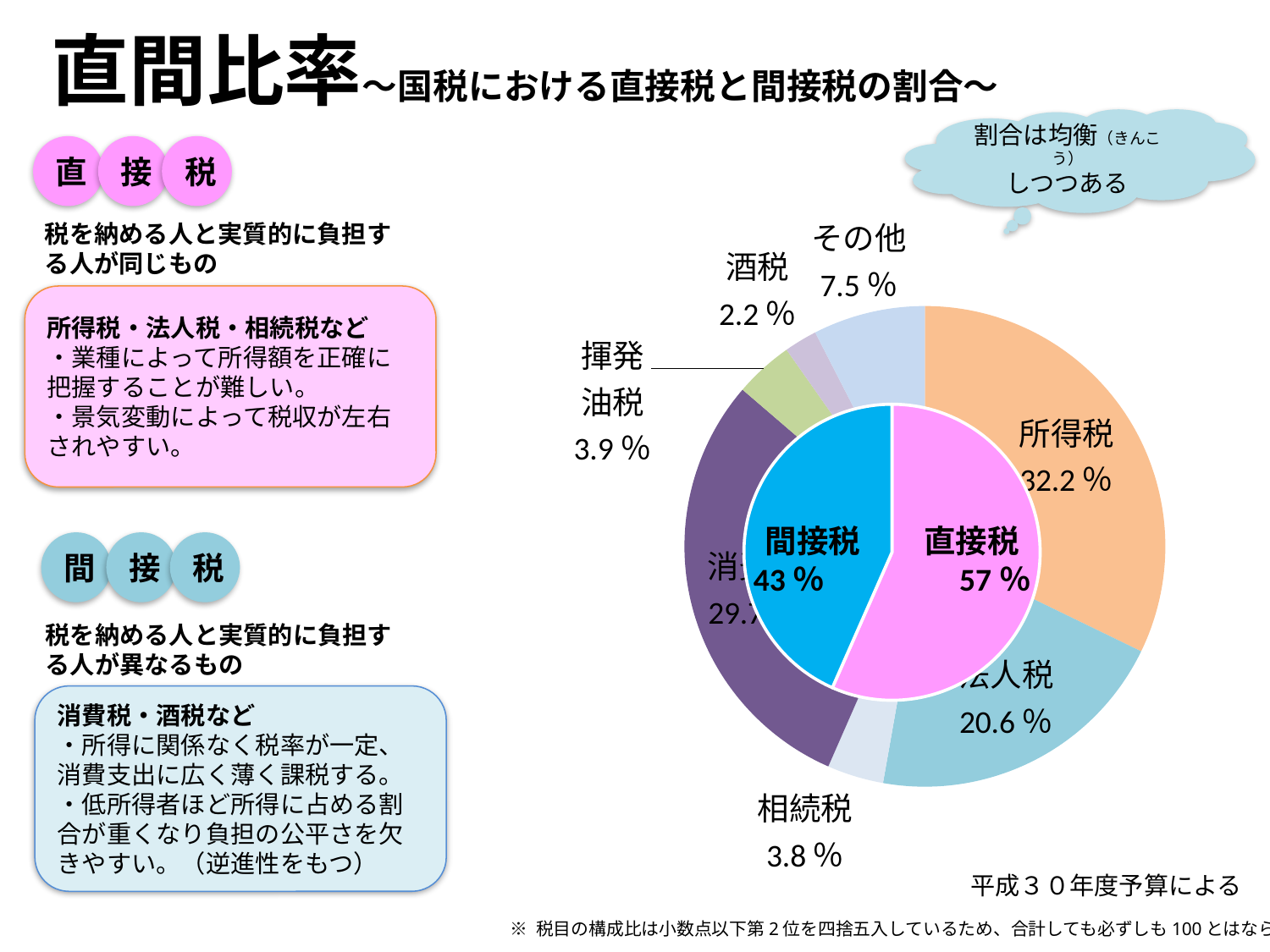
What is the share shown for 法人税 in the outer ring? 20.6 % By how many percentage points does 直接税 exceed 間接税 in the inner pie? 14 % What kind of chart is shown on the slide? pie chart What percentage does the inner pie show for 直接税? 57 % Which is larger in the inner pie, 直接税 or 間接税? 直接税 What is the share shown for 相続税? 3.8 % What is the share shown for 酒税? 2.2 % What is the share shown for 所得税 in the outer ring? 32.2 % What percentage does the inner pie show for 間接税? 43 % Which tax has the largest share in the outer ring? 所得税 Which tax has the smallest share in the outer ring? 酒税 What is the share shown for その他? 7.5 %